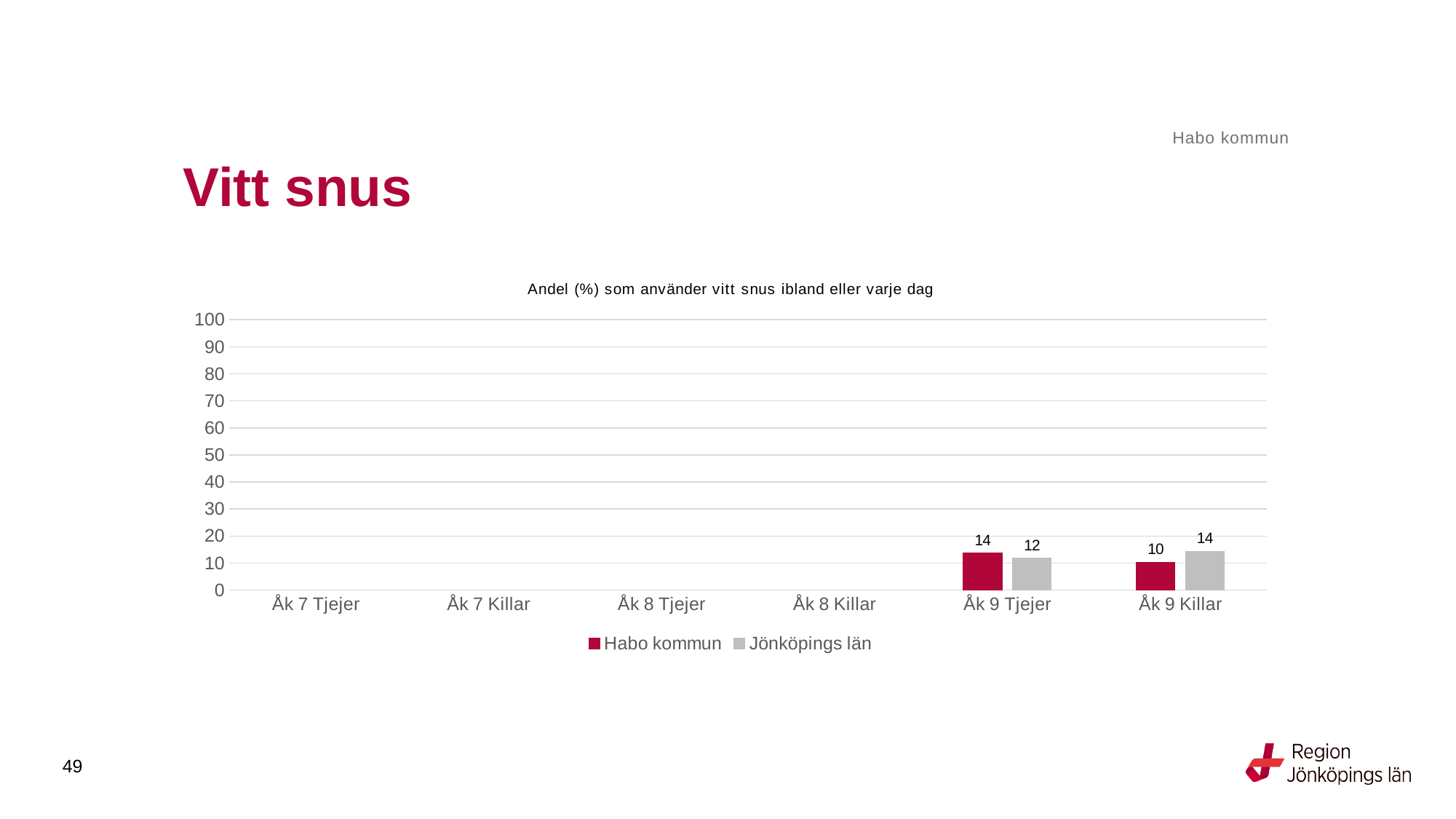
What is the difference between the Habo kommun and Jönköpings län values for Åk 9 Killar? 4 Is the value for Habo kommun for Åk 9 Tjejer greater or less than 20? less What is the value for Jönköpings län for Åk 9 Tjejer? 12 What is the value for Jönköpings län for Åk 9 Killar? 14 How many categories are shown on the x axis? 6 What is the value for Habo kommun for Åk 9 Killar? 10 For Åk 9 Tjejer, which series has the larger value, Habo kommun or Jönköpings län? Habo kommun What is the value for Habo kommun for Åk 9 Tjejer? 14 For Åk 9 Killar, which series has the larger value, Habo kommun or Jönköpings län? Jönköpings län What is the difference between the Habo kommun and Jönköpings län values for Åk 9 Tjejer? 2 How many series does the legend list? 2 What kind of chart is shown on the slide? bar chart